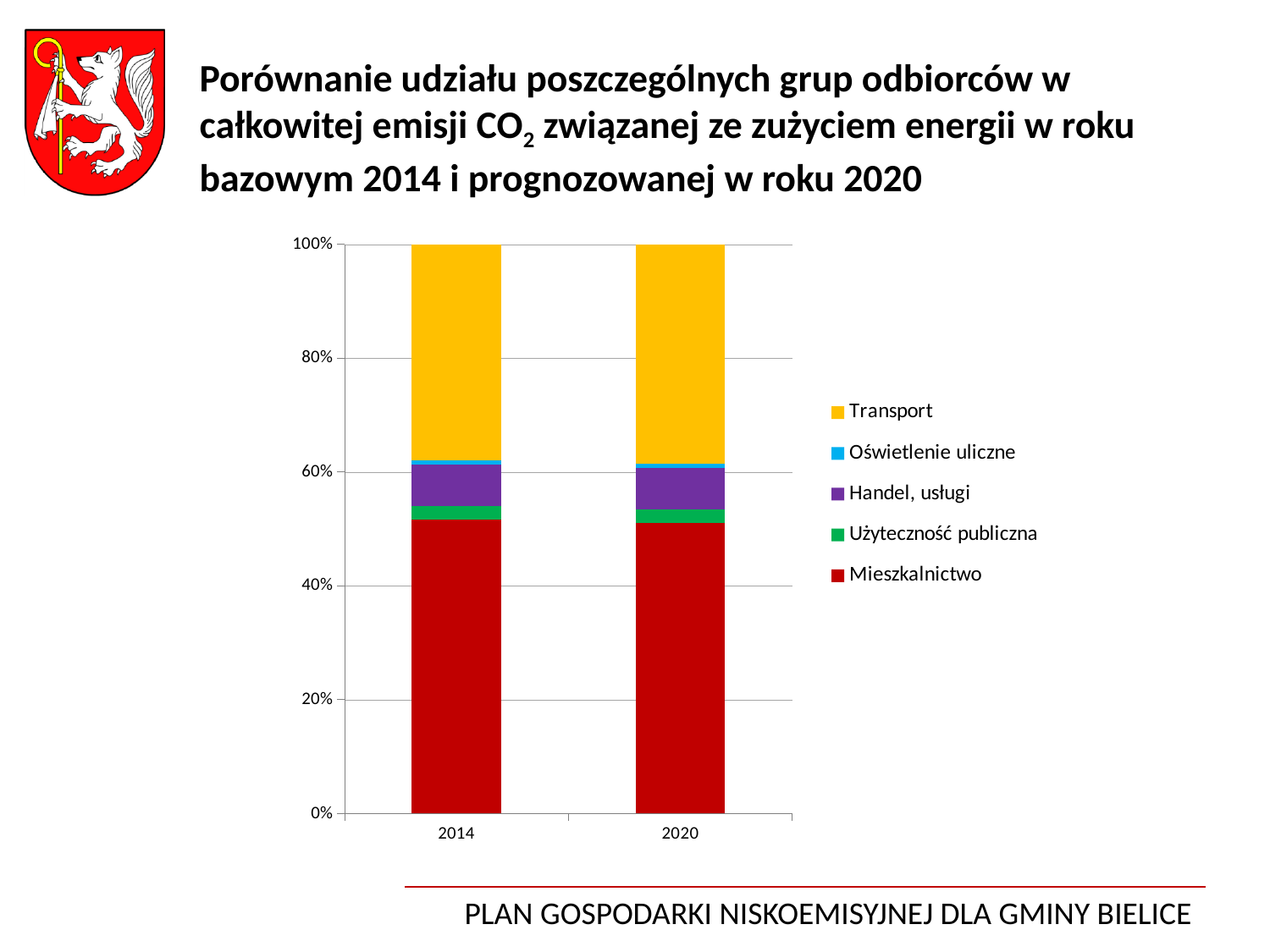
Which series is shown at the bottom of each stacked bar? Mieszkalnictwo Is the share of Mieszkalnictwo in 2014 greater or less than 40%? greater Which group has the largest share of emissions in 2014? Mieszkalnictwo What is the total height of the stacked bar for 2020? 100% Which group has the smallest share of emissions in 2020? Oświetlenie uliczne What kind of chart is shown on the slide? stacked bar chart How many series does the chart legend list? 5 In 2014, which has the larger share: Mieszkalnictwo or Transport? Mieszkalnictwo Which colour represents Transport in the chart? yellow Is the share of Mieszkalnictwo in 2020 greater or less than 60%? less How many years (categories) are shown on the x axis of the chart? 2 What is the total height of the stacked bar for 2014? 100%